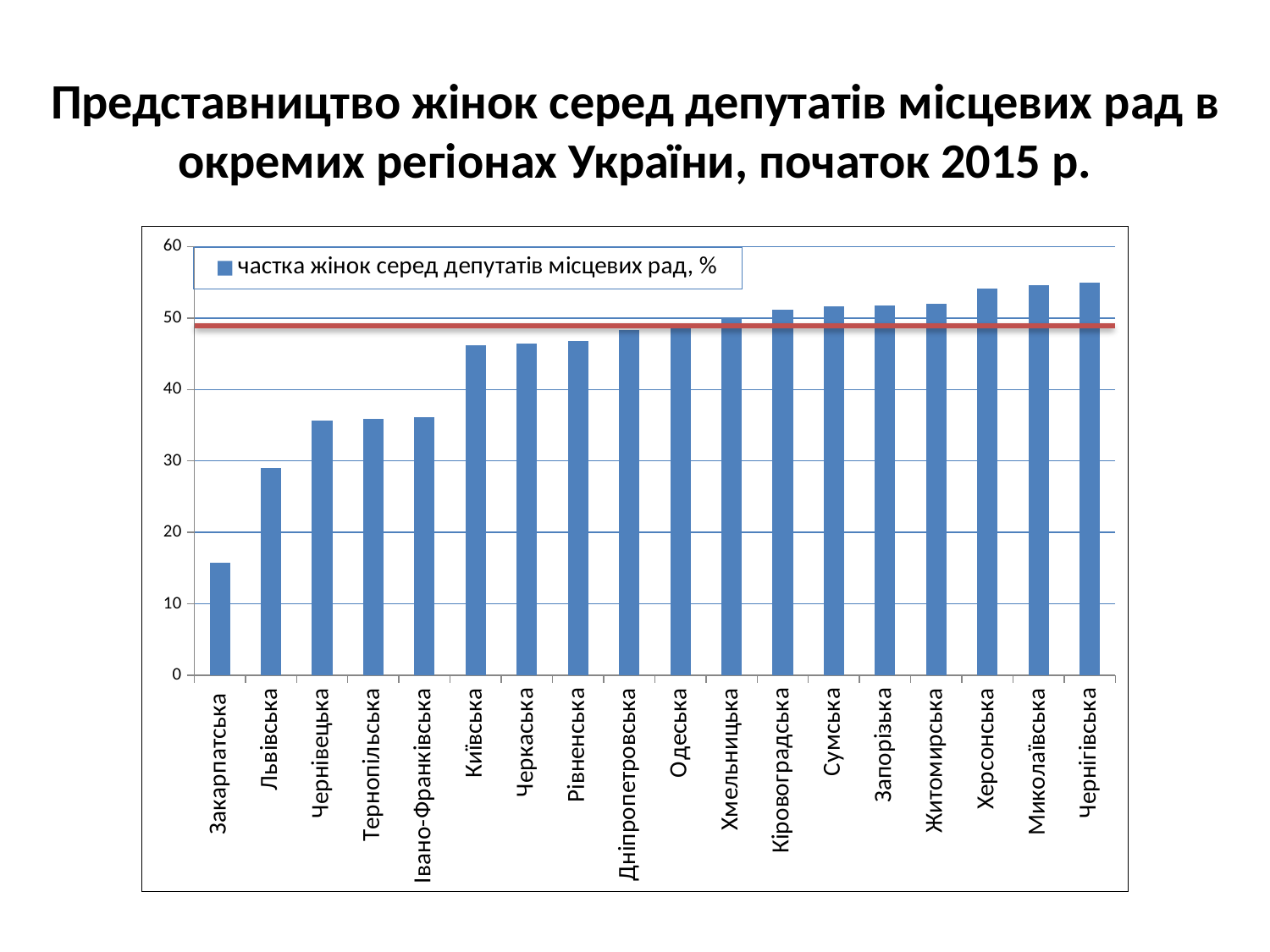
Is the value for Львівська greater or less than 30? less Is the value for Чернігівська greater or less than 50? greater Is the value for Рівненська greater or less than 50? less Do the values rise or fall moving from left to right along the x axis? rise Which region has the lowest share of women among local council deputies? Закарпатська How many regions (categories) are plotted on the chart? 18 Which is larger, the value for Львівська or the value for Київська? Київська What series name is shown in the chart legend? частка жінок серед депутатів місцевих рад, % How many series does the legend list? 1 What kind of chart is shown on the slide? bar chart